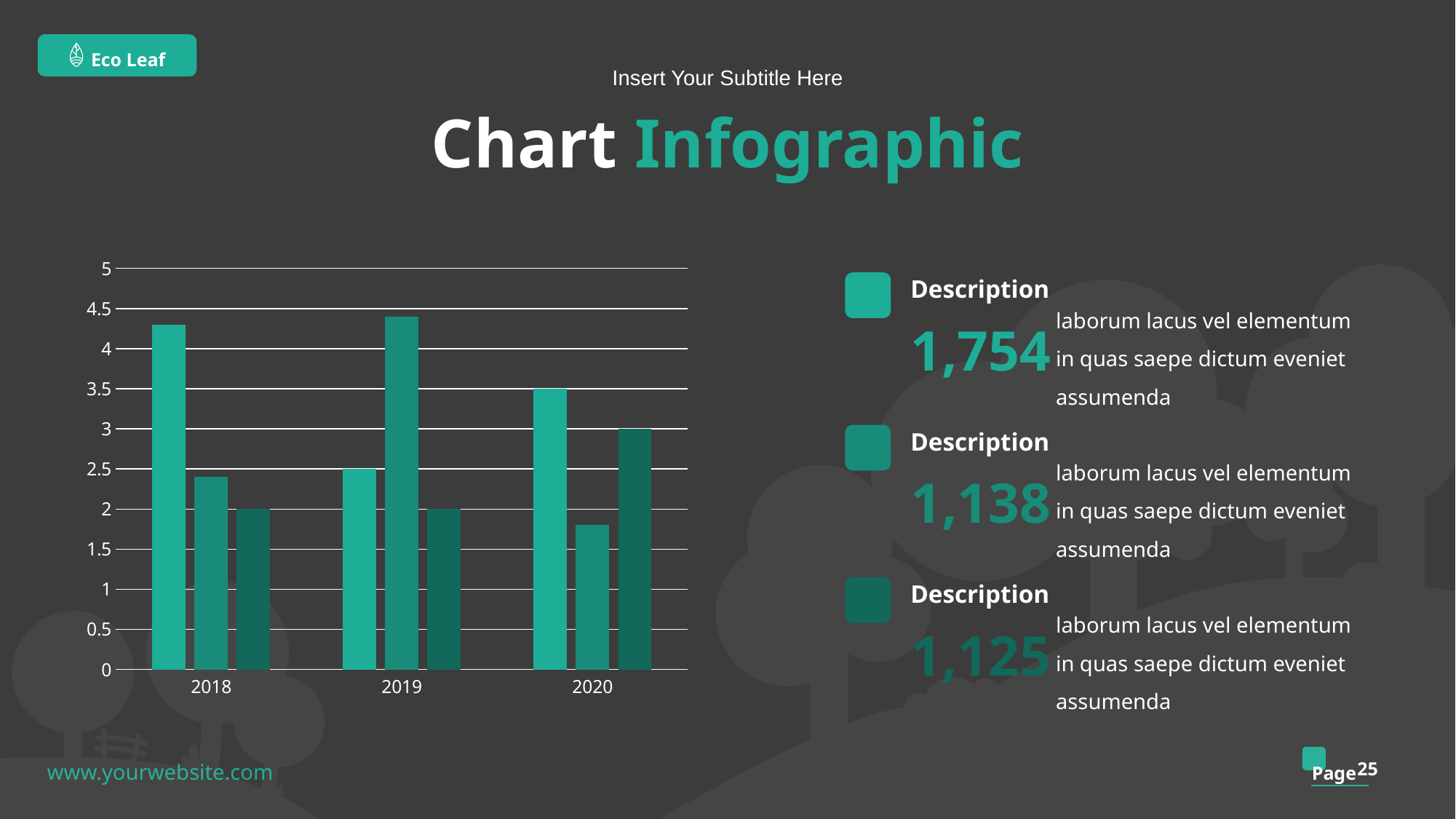
What is the difference between the first (lightest) bar and the third (darkest) bar for 2020? 0.5 What is the value of the darkest (third) bar for 2020? 3 What is the value of the darkest (third) bar for 2018? 2 For 2020, which is larger: the first (lightest) bar or the second (middle) bar? the first (lightest) bar Is the value of the lightest (first) bar for 2018 greater or less than 4? greater Within the 2018 group, which bar is the tallest? the first (lightest teal) bar Is the value of the middle (second) bar for 2020 greater or less than 2? less How many year categories are shown on the x axis of the chart? 3 What is the value of the lightest (first) bar for 2020? 3.5 What kind of chart is shown on the slide? bar chart Is the value of the middle (second) bar for 2019 greater or less than 4? greater What is the highest tick value shown on the y axis? 5